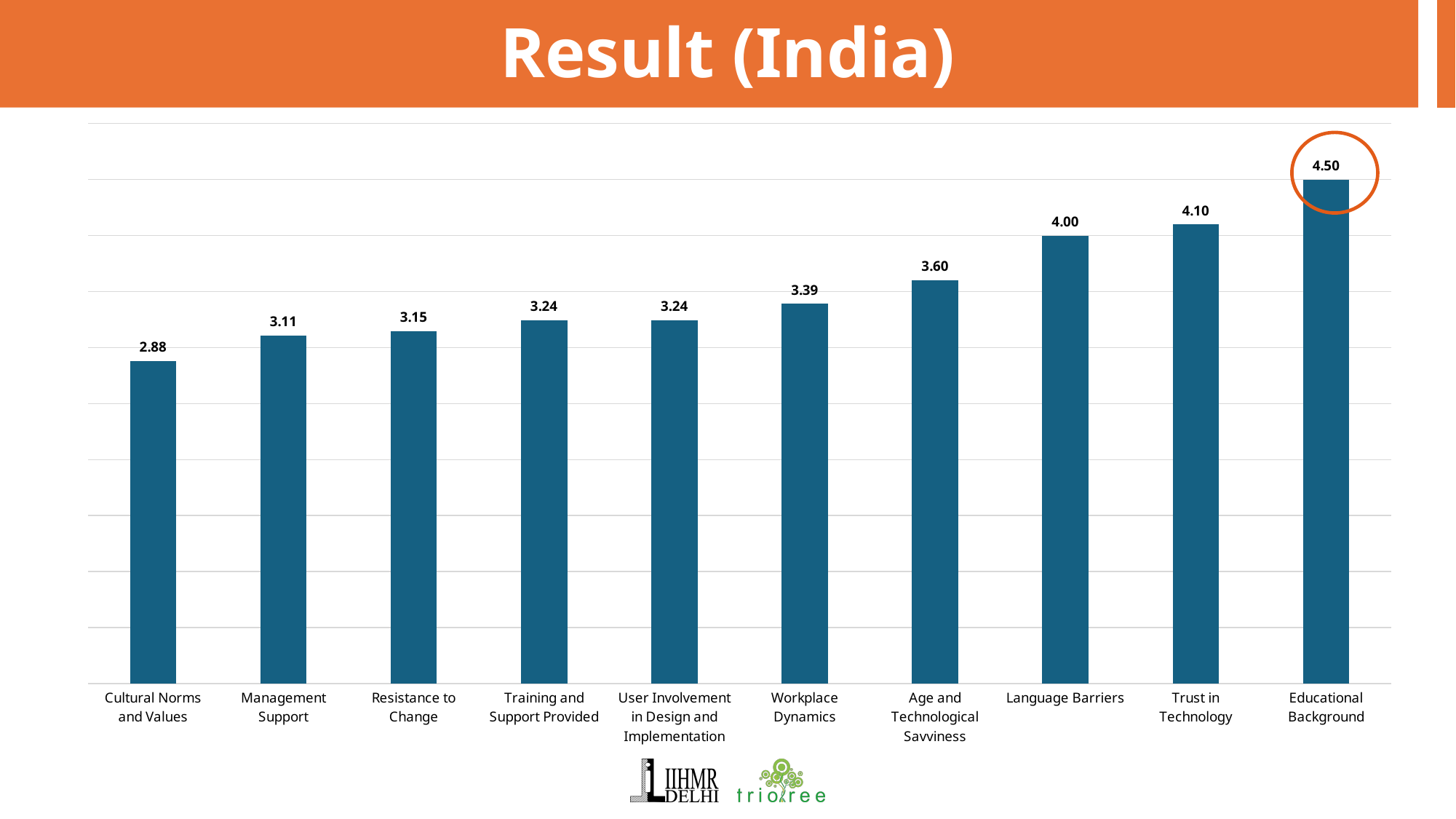
What is the value for Cultural Norms and Values? 2.88 What is the difference between the values for Educational Background and Cultural Norms and Values? 1.62 Which category has the highest value? Educational Background Do the values rise or fall from left to right along the x axis? Rise What is the value for Workplace Dynamics? 3.39 What is the value for Language Barriers? 4.00 What is the value for Educational Background? 4.50 What kind of chart is shown on the slide? Bar chart How many categories are shown in the chart? 10 Which is larger, the value for Age and Technological Savviness or the value for Resistance to Change? Age and Technological Savviness What is the difference between the values for Trust in Technology and Language Barriers? 0.10 Which category has the lowest value? Cultural Norms and Values